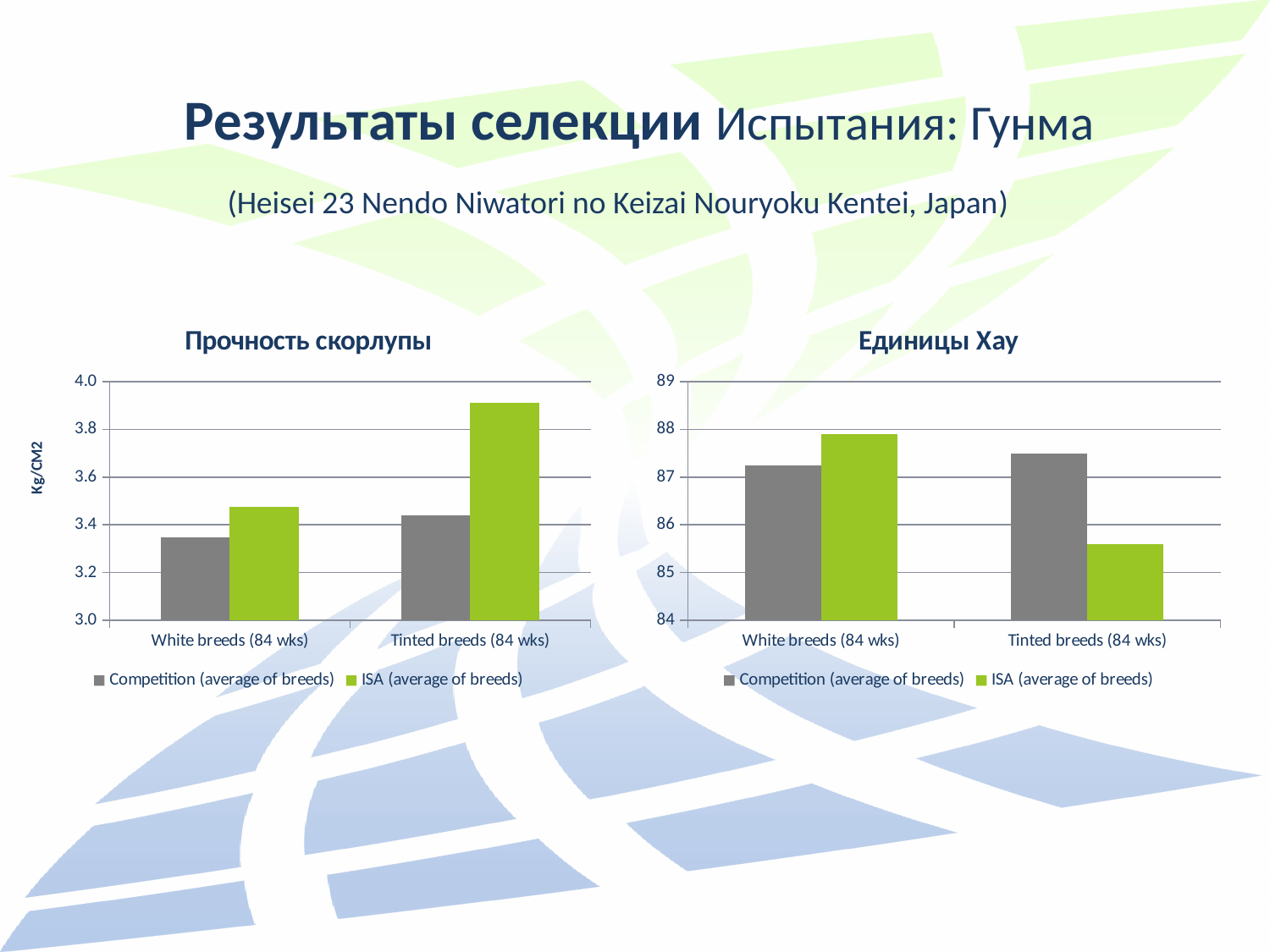
In the "Единицы Хау" chart, for Tinted breeds (84 wks), which series has the larger value: Competition or ISA? Competition (average of breeds) How many categories are shown on the x axis of the "Прочность скорлупы" chart? 2 In the "Прочность скорлупы" chart, which bar is the highest? ISA (average of breeds), Tinted breeds (84 wks) In the "Прочность скорлупы" chart, is the ISA value for Tinted breeds (84 wks) greater or less than 3.8? greater In the "Прочность скорлупы" chart, is the Competition value for White breeds (84 wks) greater or less than 3.4? less How many series does the legend of the "Единицы Хау" chart list? 2 What kind of chart is the "Прочность скорлупы" chart? bar chart In the "Единицы Хау" chart, which bar is the lowest? ISA (average of breeds), Tinted breeds (84 wks) In the "Прочность скорлупы" chart, which bar is the lowest? Competition (average of breeds), White breeds (84 wks) In the "Прочность скорлупы" chart, for Tinted breeds (84 wks), which series has the larger value: Competition or ISA? ISA (average of breeds) In the "Единицы Хау" chart, is the ISA value for Tinted breeds (84 wks) greater or less than 86? less What is the y-axis label of the "Прочность скорлупы" chart? Kg/CM2